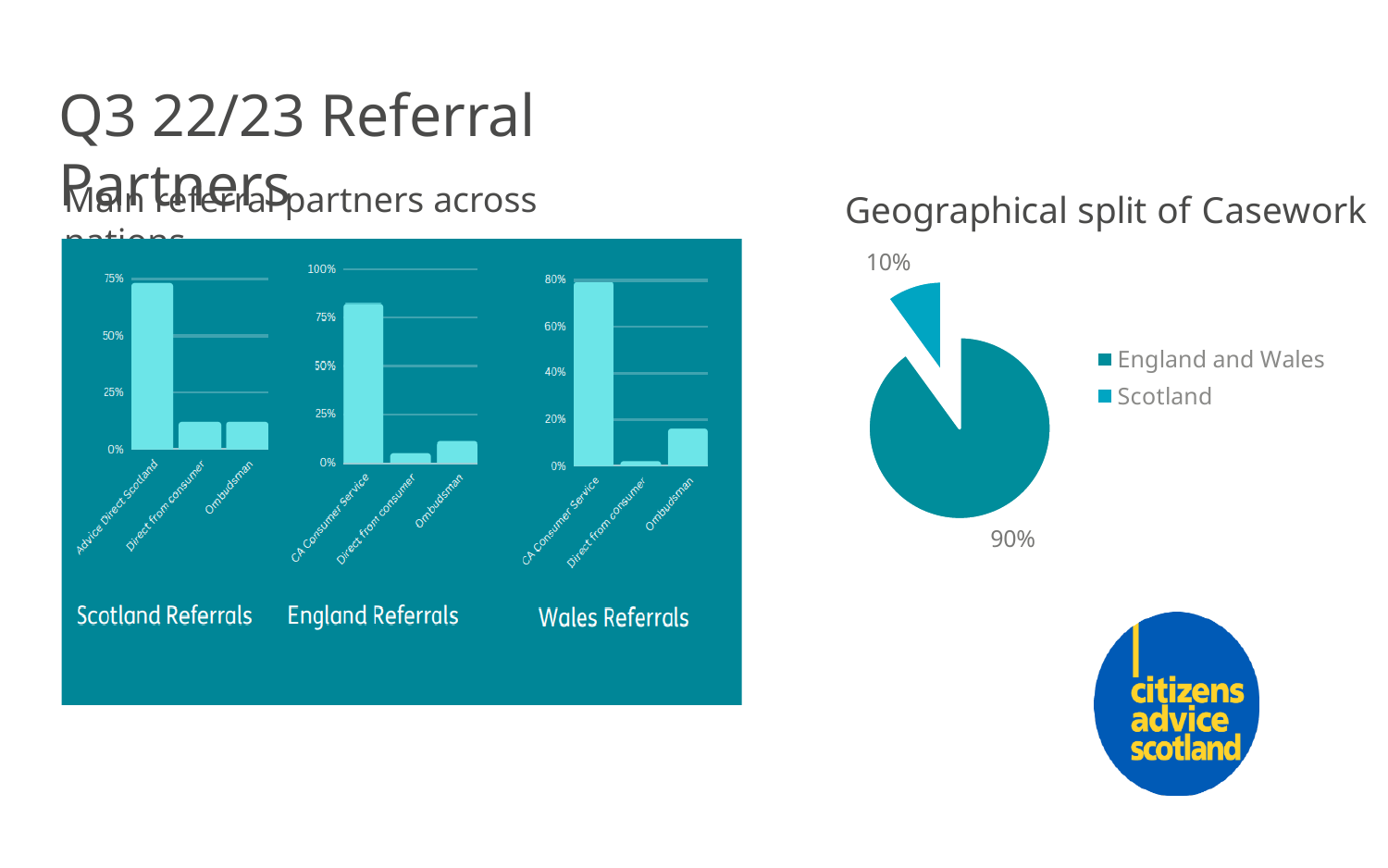
How many entries does the legend of the Geographical split of Casework chart list? 2 How many referral partner categories are shown in the Wales Referrals chart? 3 In the Wales Referrals chart, which referral partner has the lowest value? Direct from consumer In the Scotland Referrals chart, is the value for Advice Direct Scotland greater or less than 50%? greater In the Geographical split of Casework pie chart, what share of casework is England and Wales? 90% In the Wales Referrals chart, which is larger: Ombudsman or Direct from consumer? Ombudsman In the England Referrals chart, is the value for CA Consumer Service greater or less than 75%? greater In the Geographical split of Casework chart, which region has the larger share of casework? England and Wales In the Scotland Referrals chart, which referral partner has the highest value? Advice Direct Scotland In the England Referrals chart, which referral partner has the highest value? CA Consumer Service What kind of chart is the Geographical split of Casework chart? Pie chart In the Geographical split of Casework pie chart, what share of casework is Scotland? 10%